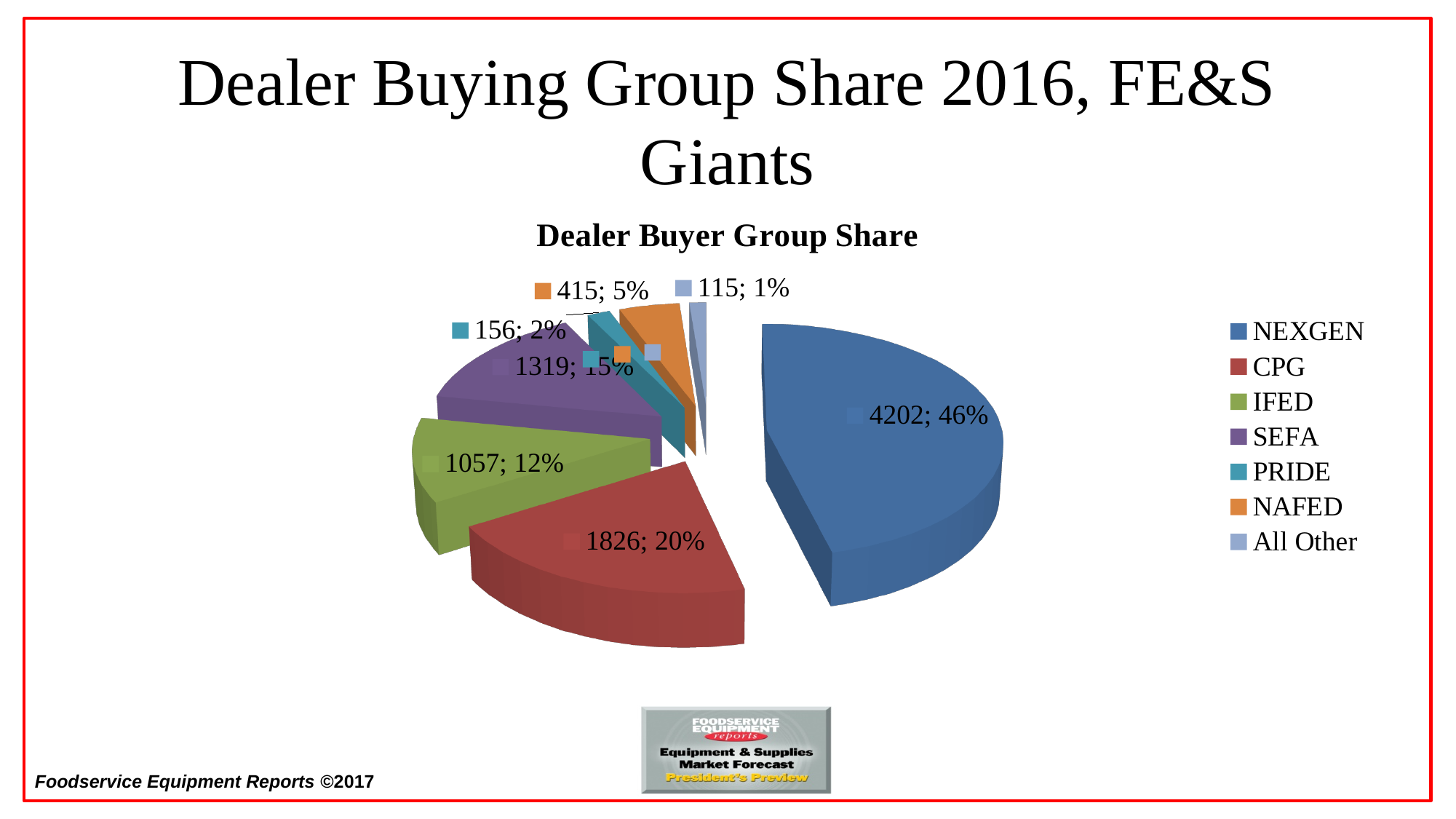
What is the difference between the values for CPG and IFED? 769 What percentage share does CPG have? 20% What percentage share does IFED have? 12% How many categories does the legend list? 7 What percentage share does PRIDE have? 2% What value is shown for NEXGEN? 4202 Which buying group has the largest share? NEXGEN What is the title of the chart? Dealer Buyer Group Share What value is shown for SEFA? 1319 Which category has the smallest share? All Other Which is larger, the value for NAFED or the value for PRIDE? NAFED What kind of chart is shown on the slide? Pie chart